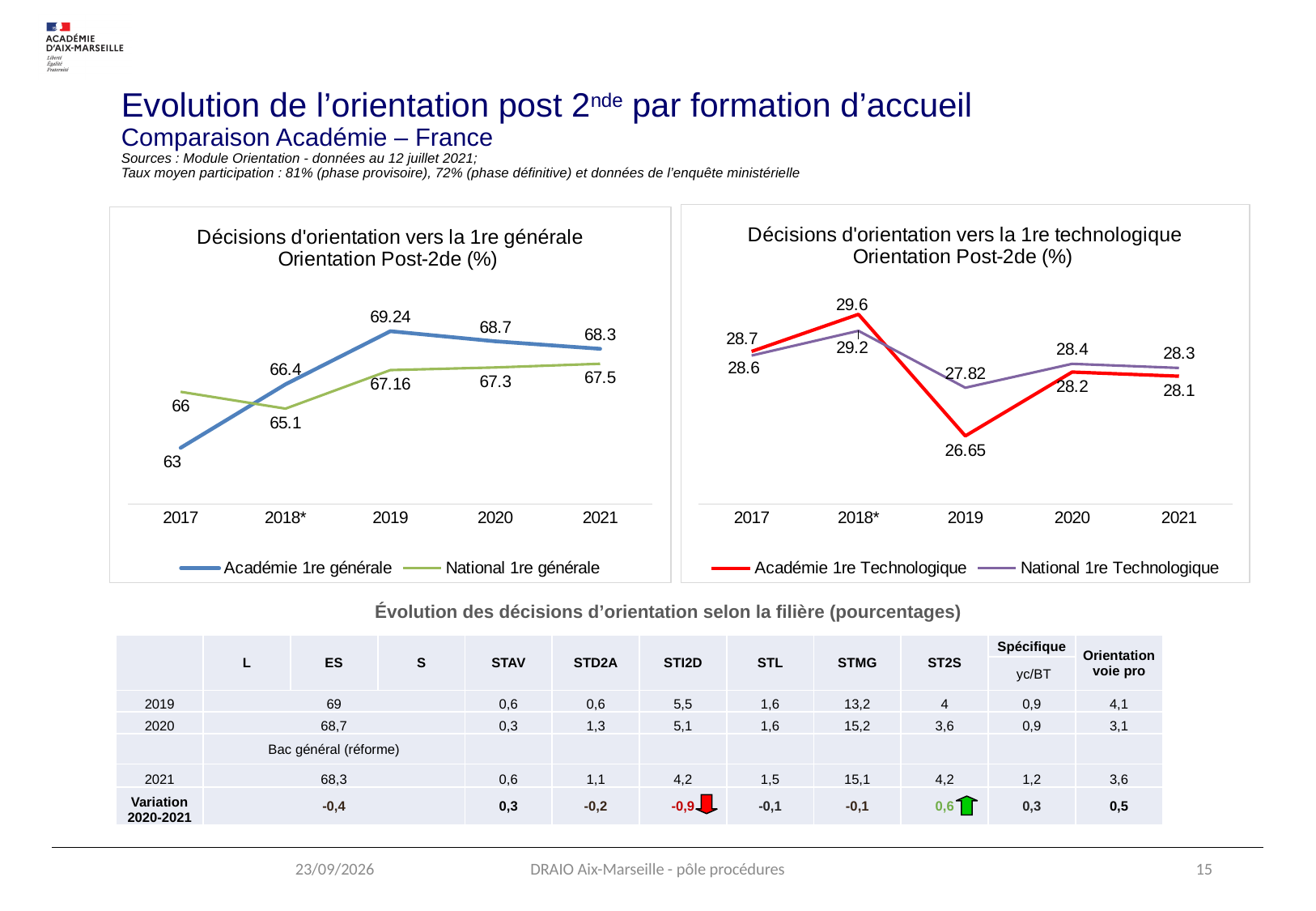
In the chart 'Décisions d'orientation vers la 1re générale', what is the value for Académie 1re générale in 2019? 69.24 What type of chart is 'Décisions d'orientation vers la 1re générale'? Line chart In the chart 'Décisions d'orientation vers la 1re générale', which series has the higher value in 2018*? Académie 1re générale In the chart 'Décisions d'orientation vers la 1re technologique', how many years are shown on the x axis? 5 In the chart 'Décisions d'orientation vers la 1re générale', what is the value for National 1re générale in 2021? 67.5 In the chart 'Décisions d'orientation vers la 1re technologique', what is the value for National 1re Technologique in 2020? 28.4 In the chart 'Décisions d'orientation vers la 1re générale', what is the difference between Académie 1re générale and National 1re générale in 2017? 3 How many series does the legend of the chart 'Décisions d'orientation vers la 1re technologique' list? 2 In the chart 'Décisions d'orientation vers la 1re technologique', what is the value for Académie 1re Technologique in 2019? 26.65 In the chart 'Décisions d'orientation vers la 1re générale', in which year is the Académie 1re générale value lowest? 2017 In the chart 'Décisions d'orientation vers la 1re technologique', what is the difference between National 1re Technologique and Académie 1re Technologique in 2019? 1.17 In the chart 'Décisions d'orientation vers la 1re technologique', in which year is the Académie 1re Technologique value highest? 2018*